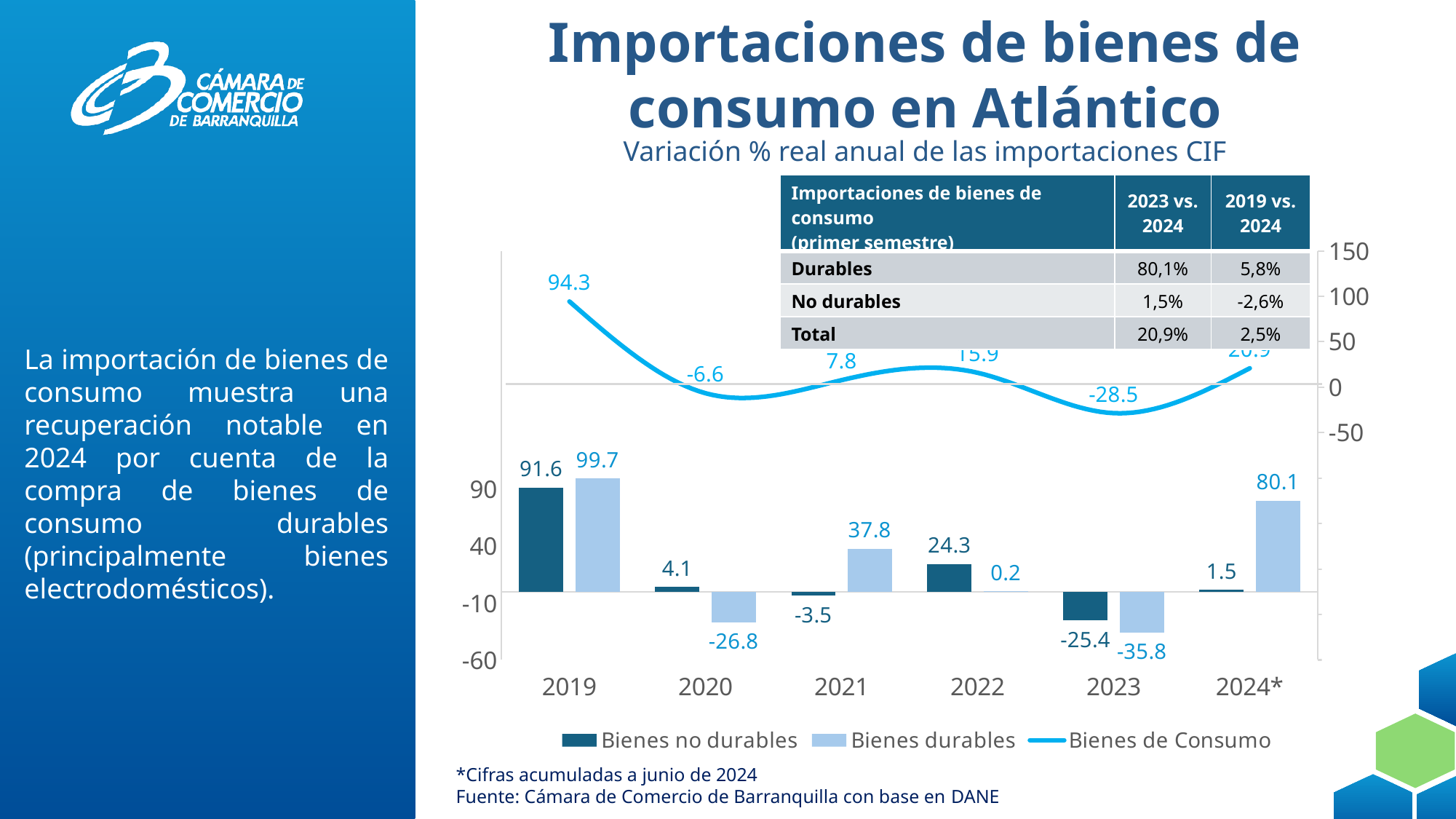
In which year is the Bienes durables bar lowest? 2023 In which year is the Bienes durables bar highest? 2019 What is the value for Bienes durables in 2024*? 80.1 What is the value for Bienes no durables in 2023? -25.4 What is the difference between Bienes durables and Bienes no durables in 2024*? 78.6 How many years are shown on the x axis? 6 What is the value of the Bienes de Consumo line in 2019? 94.3 Which is larger in 2021, Bienes no durables or Bienes durables? Bienes durables What is the value of the Bienes de Consumo line in 2020? -6.6 What kind of chart is shown? Combined bar and line chart How many series does the legend list? 3 What is the value for Bienes durables in 2019? 99.7